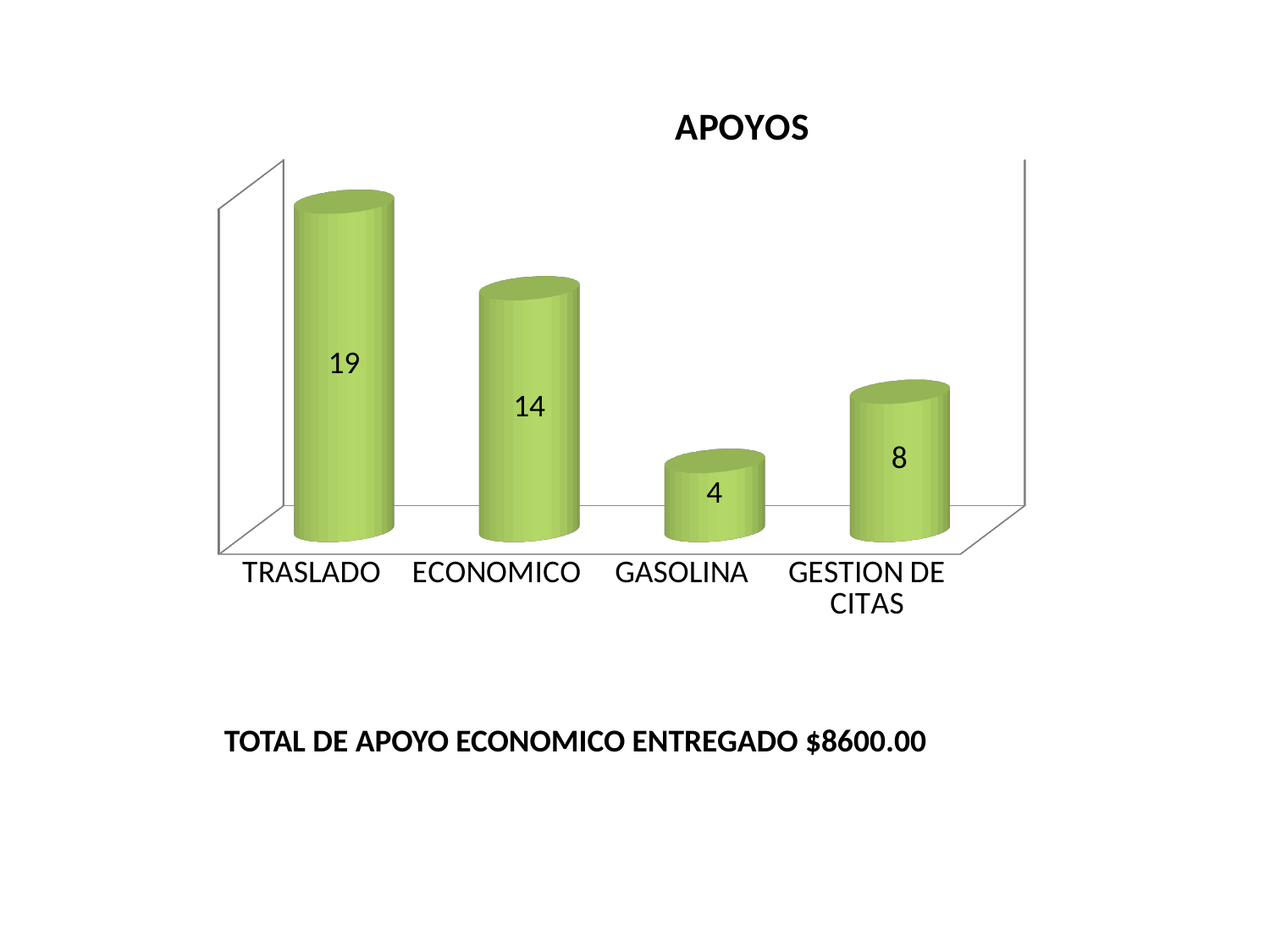
What is the difference between the values for TRASLADO and ECONOMICO? 5 What kind of chart is shown on the slide? bar chart What is the value for TRASLADO? 19 What is the value for GESTION DE CITAS? 8 What is the value for ECONOMICO? 14 What is the difference between the values for GESTION DE CITAS and GASOLINA? 4 Which category has the lowest value? GASOLINA Which category has the highest value? TRASLADO What is the title of the chart? APOYOS How many categories are shown in the chart? 4 What is the value for GASOLINA? 4 Which is larger, the value for ECONOMICO or the value for GESTION DE CITAS? ECONOMICO